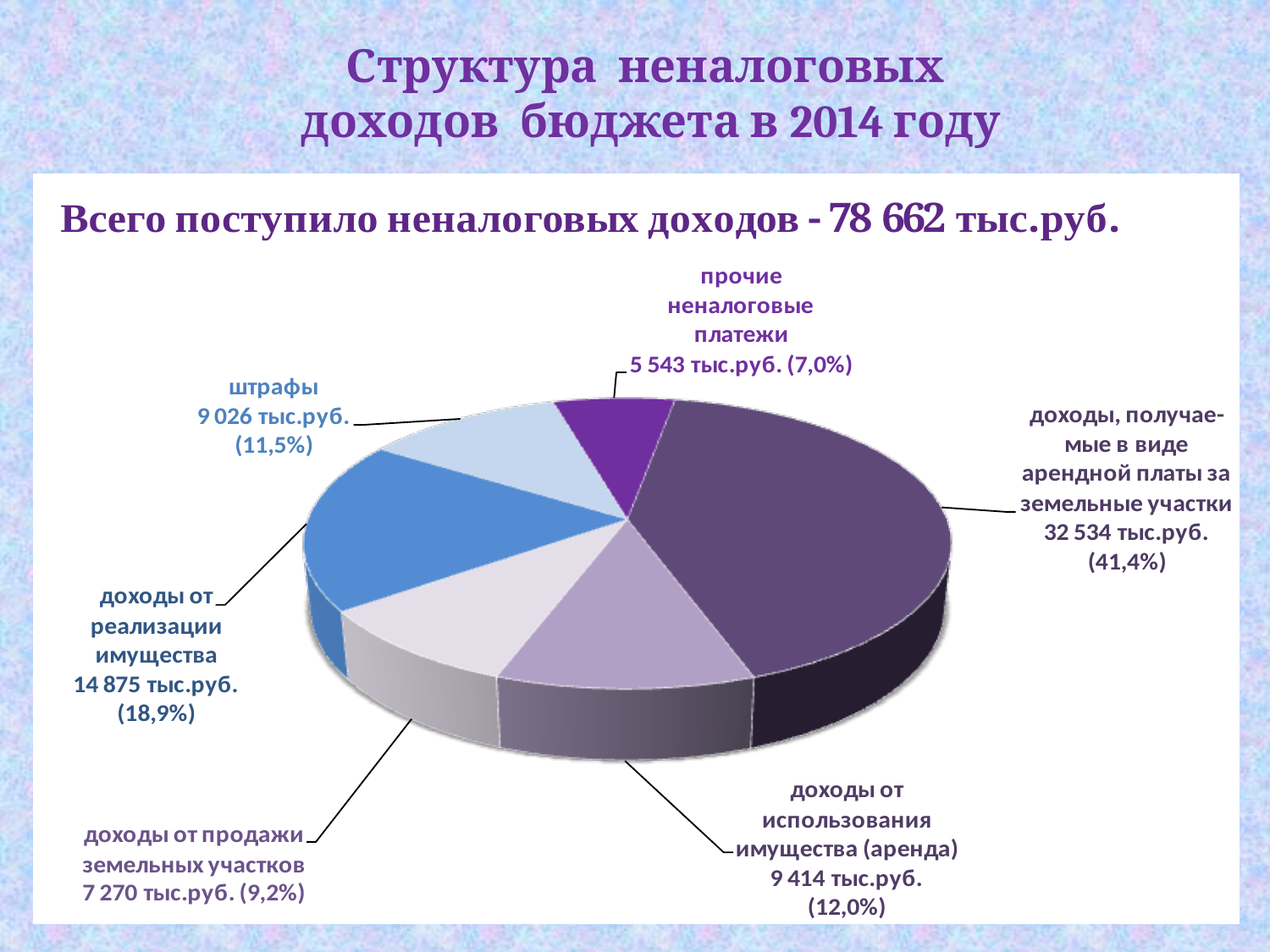
What share of the pie is доходы от использования имущества (аренда)? 12,0% Which category has the largest slice? доходы, получаемые в виде арендной платы за земельные участки What is the difference between the value for доходы от реализации имущества and the value for штрафы? 5 849 тыс.руб. What is the value for доходы от реализации имущества? 14 875 тыс.руб. What kind of chart is shown on the slide? pie chart Which category has the smallest slice? прочие неналоговые платежи What share of the pie is доходы от продажи земельных участков? 9,2% Which is larger: доходы от использования имущества (аренда) or доходы от продажи земельных участков? доходы от использования имущества (аренда) What is the value for прочие неналоговые платежи? 5 543 тыс.руб. What total amount of non-tax revenue is stated on the slide? 78 662 тыс.руб. What is the value for штрафы? 9 026 тыс.руб. How many slices does the pie chart have? 6